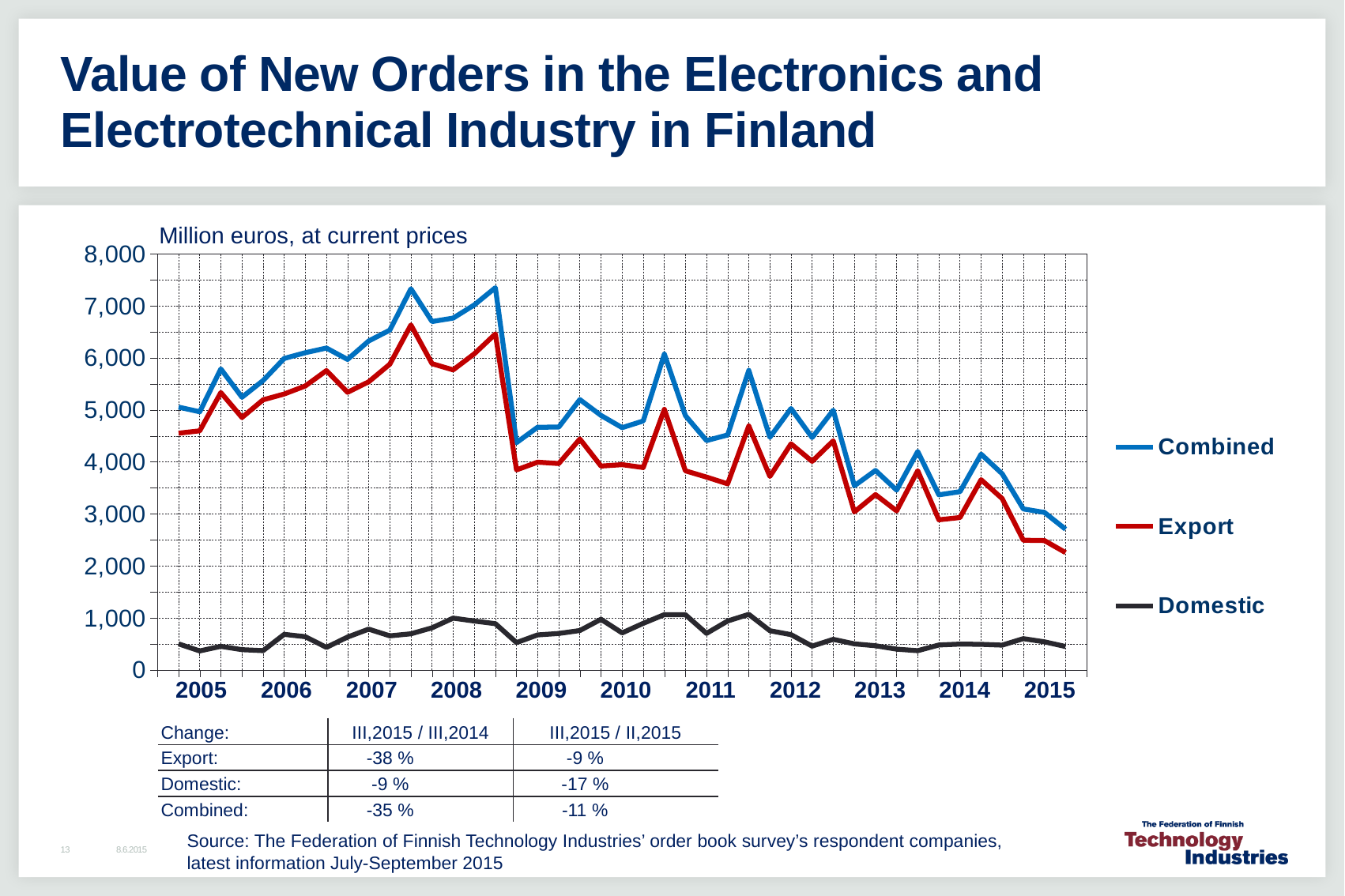
In 2010, which is larger, the Combined value or the Domestic value? Combined How many years are labelled on the x axis? 11 What unit label is shown above the y axis of the chart? Million euros, at current prices Is the Combined value at its 2008 peak greater or less than 7,000? greater Is the Export value at the last point in 2015 greater or less than 3,000? less What kind of chart is shown on the slide? Line chart Does the Combined series rise or fall from 2012 to 2015? Fall How many series does the chart's legend list? 3 Which series has the highest values throughout the chart? Combined Is the Domestic value at the first point in 2005 greater or less than 1,000? less Which series has the lowest values throughout the chart? Domestic